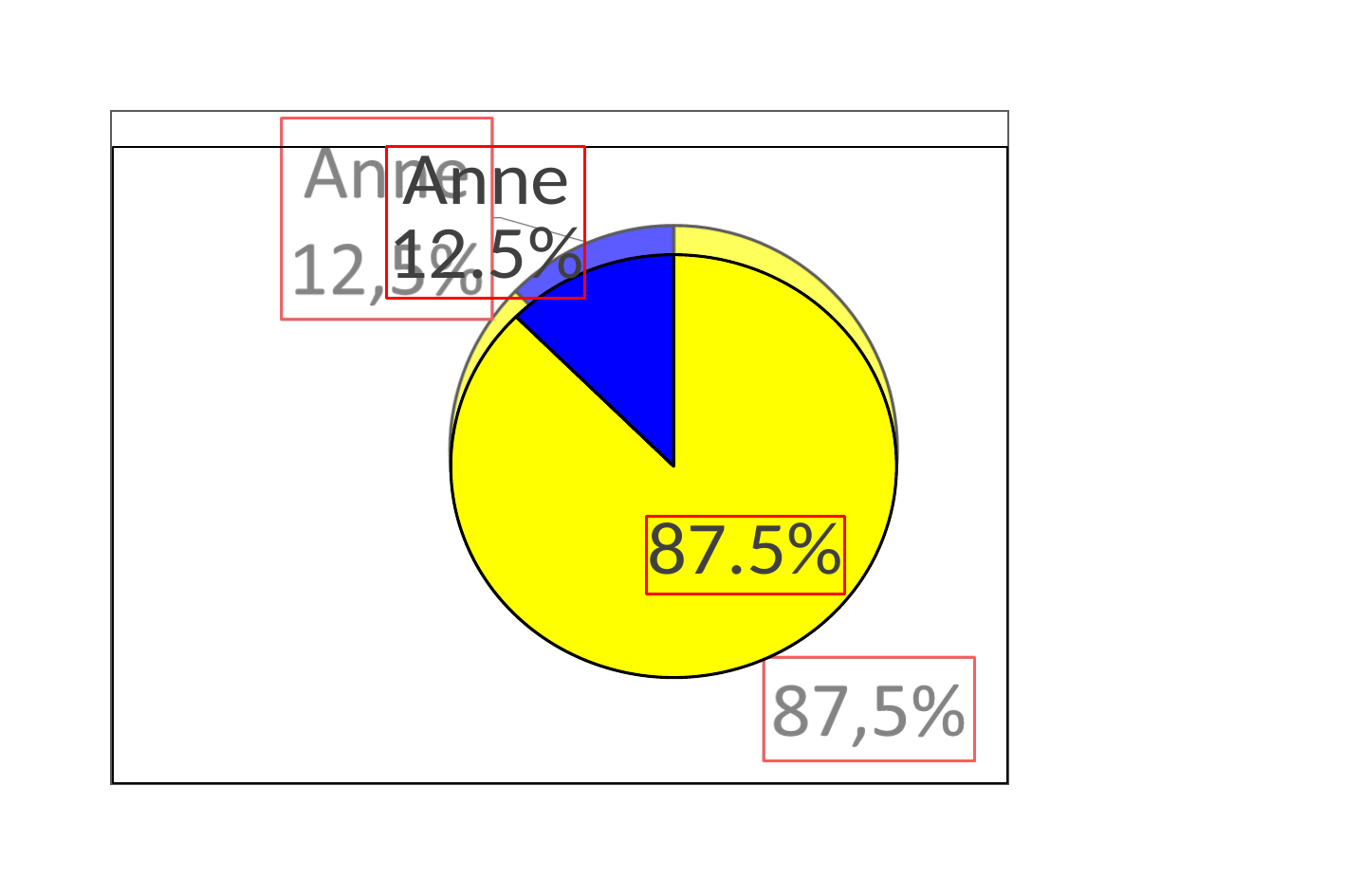
Which slice of the pie chart is the smallest? Anne Is the share for Anne greater or less than 25%? less What percentage is shown on the yellow slice of the pie chart? 87.5% Which slice of the pie chart is the largest? the yellow slice (87.5%) What share of the pie does the slice labelled Anne represent? 12.5% What kind of chart is shown on the slide? pie chart How many slices does the pie chart have? 2 Is the slice labelled Anne larger or smaller than the yellow slice? smaller What is the difference in percentage points between the yellow slice and the Anne slice? 75 percentage points What colour is the slice labelled Anne? blue